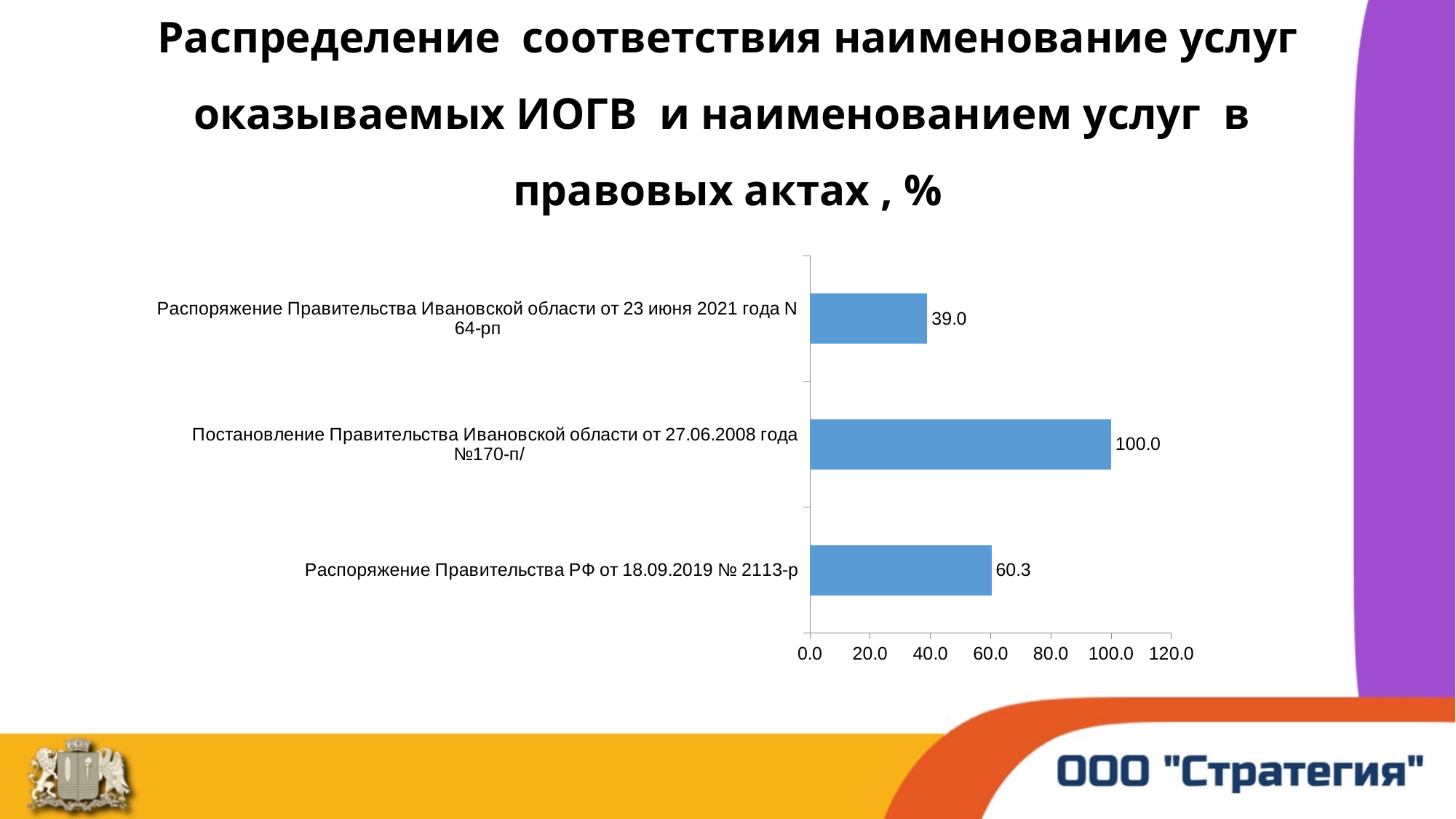
What is the maximum value shown on the horizontal axis? 120.0 What is the value for Распоряжение Правительства РФ от 18.09.2019 № 2113-р? 60.3 What is the difference between the values for Распоряжение Правительства РФ от 18.09.2019 № 2113-р and Распоряжение Правительства Ивановской области от 23 июня 2021 года N 64-рп? 21.3 What kind of chart is shown on the slide? bar chart What is the value for Постановление Правительства Ивановской области от 27.06.2008 года №170-п/? 100.0 How many categories are shown in the chart? 3 What is the value for Распоряжение Правительства Ивановской области от 23 июня 2021 года N 64-рп? 39.0 What is the difference between the values for Постановление Правительства Ивановской области от 27.06.2008 года №170-п/ and Распоряжение Правительства РФ от 18.09.2019 № 2113-р? 39.7 Which is larger: the value for Распоряжение Правительства РФ от 18.09.2019 № 2113-р or the value for Распоряжение Правительства Ивановской области от 23 июня 2021 года N 64-рп? Распоряжение Правительства РФ от 18.09.2019 № 2113-р Is the value for Распоряжение Правительства Ивановской области от 23 июня 2021 года N 64-рп greater or less than 40.0? less Which category has the lowest value? Распоряжение Правительства Ивановской области от 23 июня 2021 года N 64-рп Which category has the highest value? Постановление Правительства Ивановской области от 27.06.2008 года №170-п/